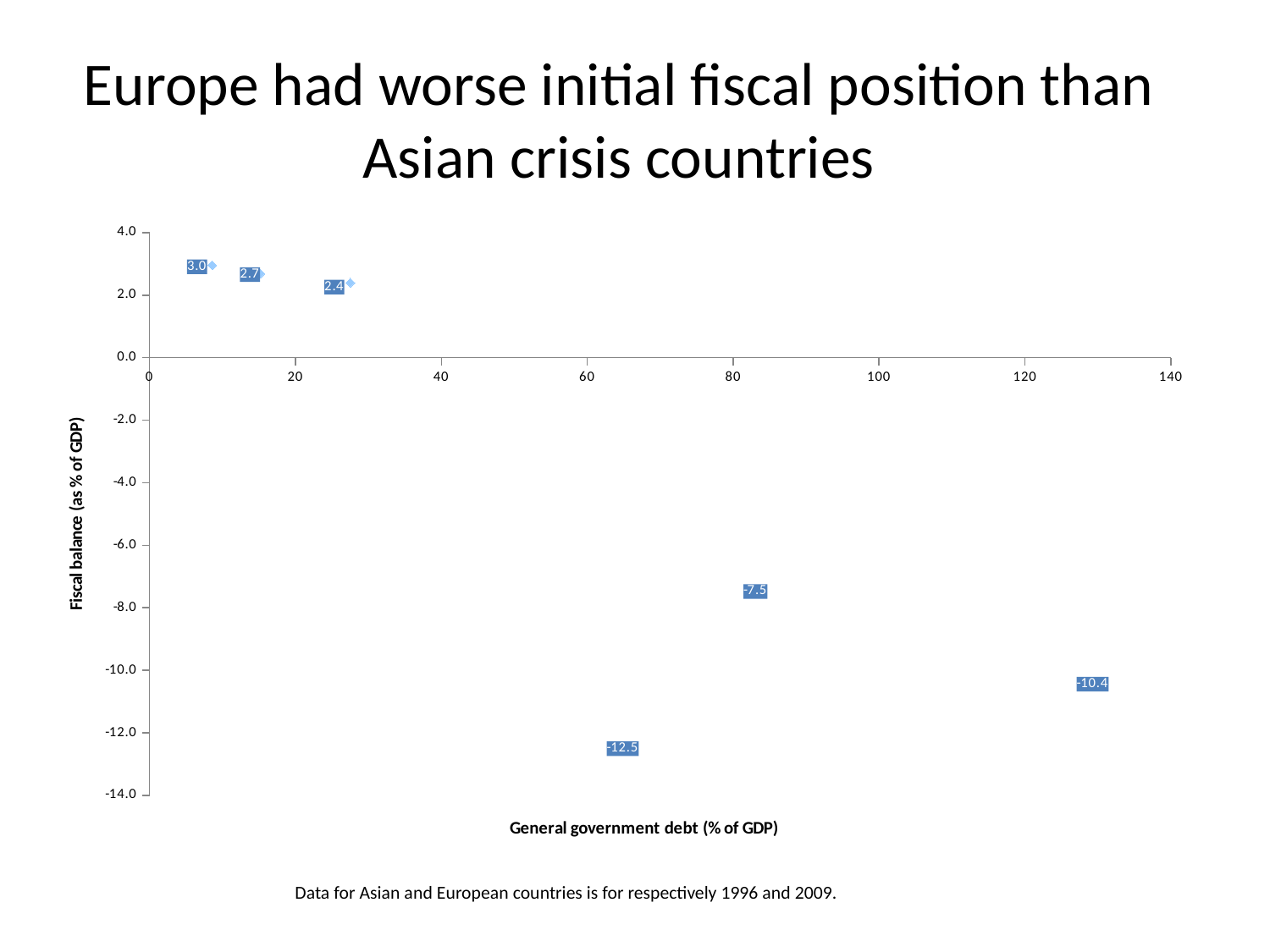
Is the general government debt for the point labelled 3.0 greater or less than 20? less What is the lowest fiscal balance value labelled on the chart? -12.5 How many points have a positive fiscal balance? 3 What is the highest fiscal balance value labelled on the chart? 3.0 Is the general government debt for the point labelled -10.4 greater or less than 120? greater What is the difference between the points labelled -7.5 and -10.4? 2.9 Is the general government debt for the point labelled -12.5 greater or less than 40? greater As general government debt increases along the x axis, does fiscal balance generally rise or fall? fall What is the title of the vertical axis? Fiscal balance (as % of GDP) How many data points are plotted on the chart? 6 What kind of chart is shown on the slide? scatter chart What is the difference between the highest labelled fiscal balance (3.0) and the lowest (-12.5)? 15.5